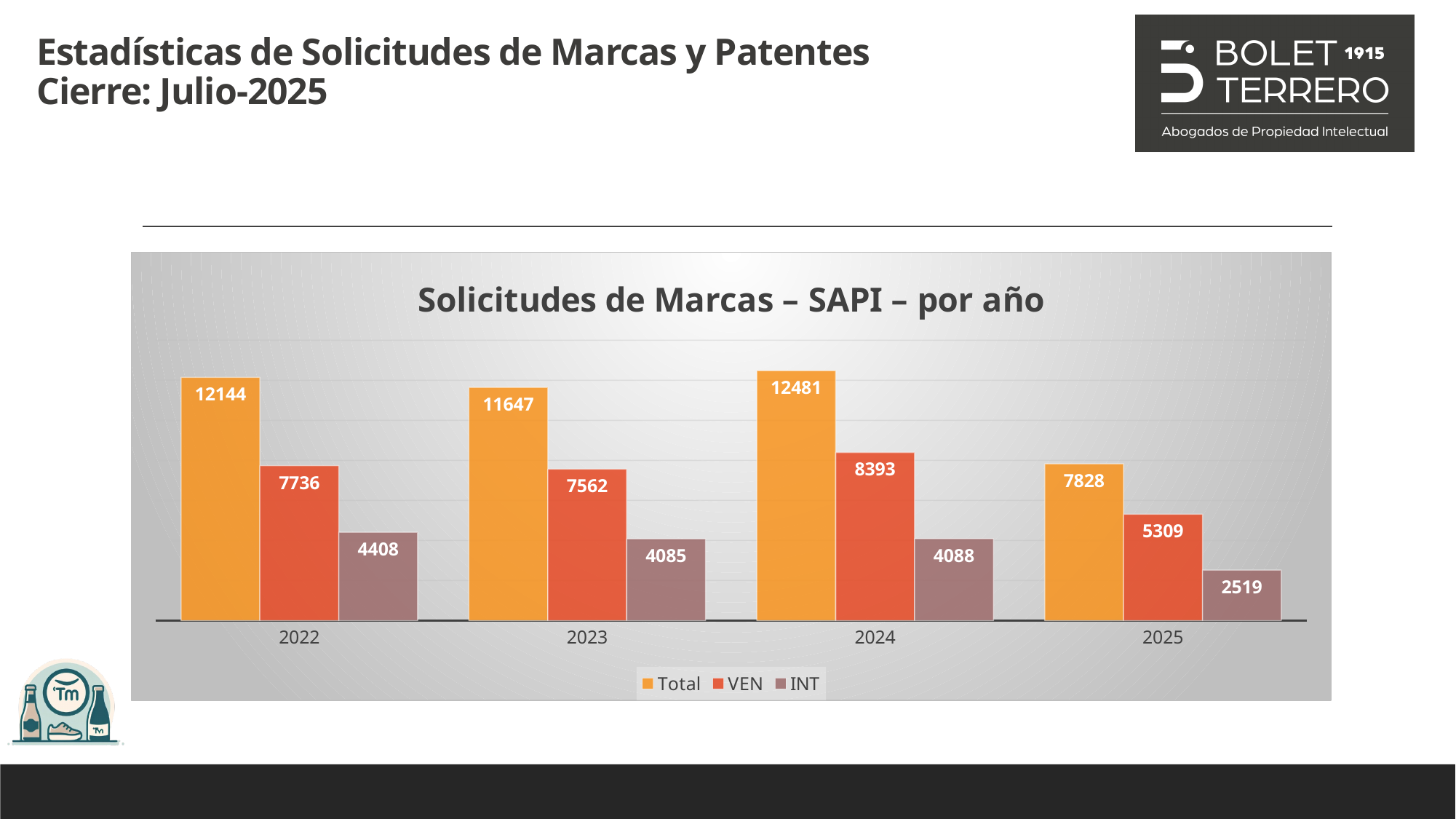
How many years are shown on the x axis? 4 Does the VEN value rise or fall from 2024 to 2025? Fall What is the VEN value for 2022? 7736 How many series does the legend list? 3 What is the INT value for 2025? 2519 Which year has the lowest INT value? 2025 Which is larger, the INT value for 2022 or the INT value for 2023? 2022 What is the title of the chart? Solicitudes de Marcas – SAPI – por año What is the Total value for 2024? 12481 What is the difference between the VEN values for 2024 and 2025? 3084 What kind of chart is shown? Bar chart Which year has the highest Total value? 2024